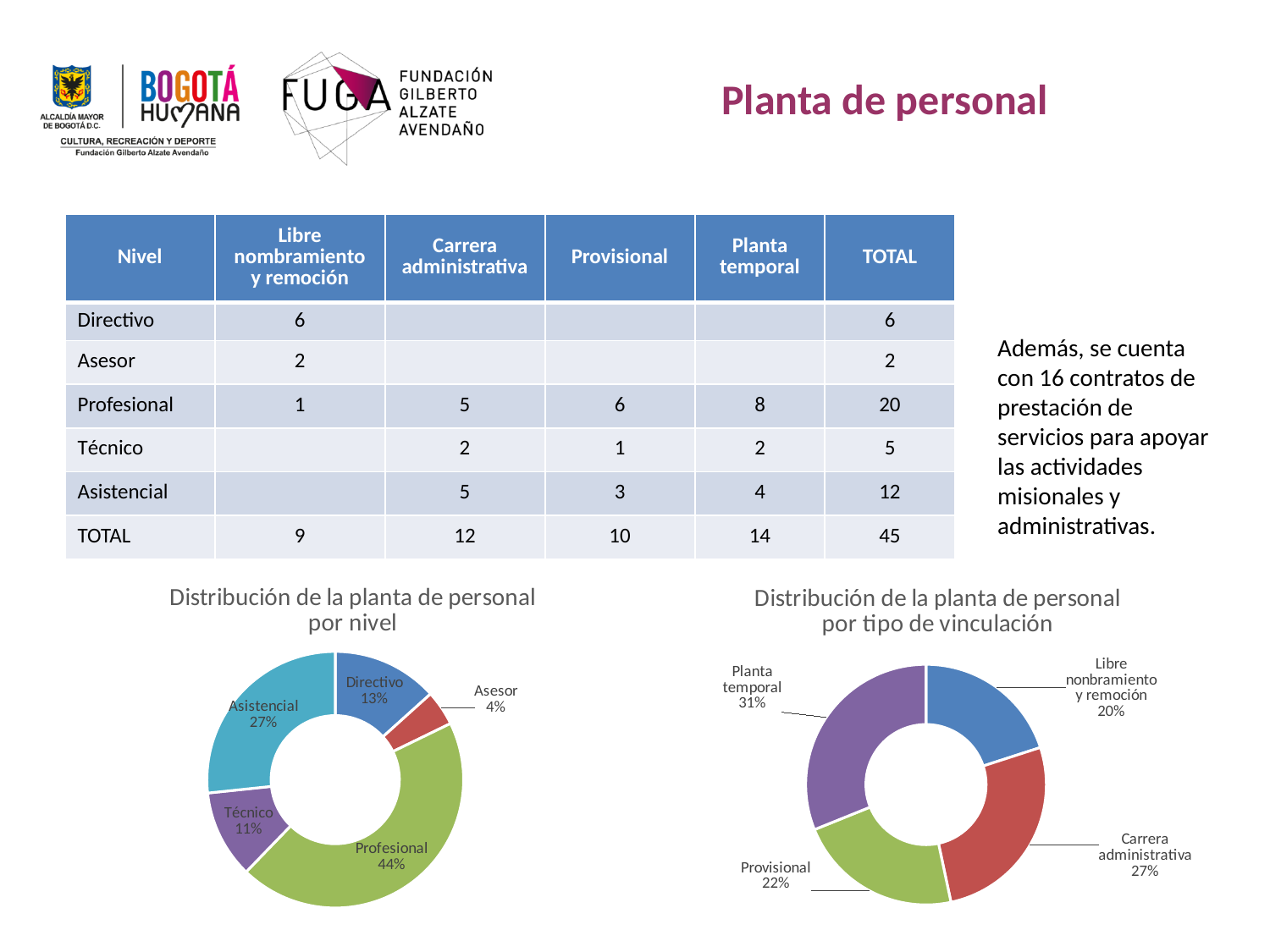
In the chart 'Distribución de la planta de personal por nivel', which level has the smallest share? Asesor In the chart 'Distribución de la planta de personal por tipo de vinculación', which is larger, Carrera administrativa or Libre nombramiento y remoción? Carrera administrativa In the chart 'Distribución de la planta de personal por nivel', how many levels are shown? 5 What kind of chart is 'Distribución de la planta de personal por tipo de vinculación'? Doughnut (pie) chart In the chart 'Distribución de la planta de personal por tipo de vinculación', which type of vinculación has the largest share? Planta temporal In the chart 'Distribución de la planta de personal por tipo de vinculación', how many categories are shown? 4 In the chart 'Distribución de la planta de personal por nivel', what share does Profesional have? 44% In the chart 'Distribución de la planta de personal por tipo de vinculación', what share does Planta temporal have? 31% In the chart 'Distribución de la planta de personal por nivel', which level has the largest share? Profesional In the chart 'Distribución de la planta de personal por nivel', what share does Asistencial have? 27% In the chart 'Distribución de la planta de personal por tipo de vinculación', what share does Provisional have? 22% In the chart 'Distribución de la planta de personal por nivel', what is the difference in percentage points between Directivo and Técnico? 2